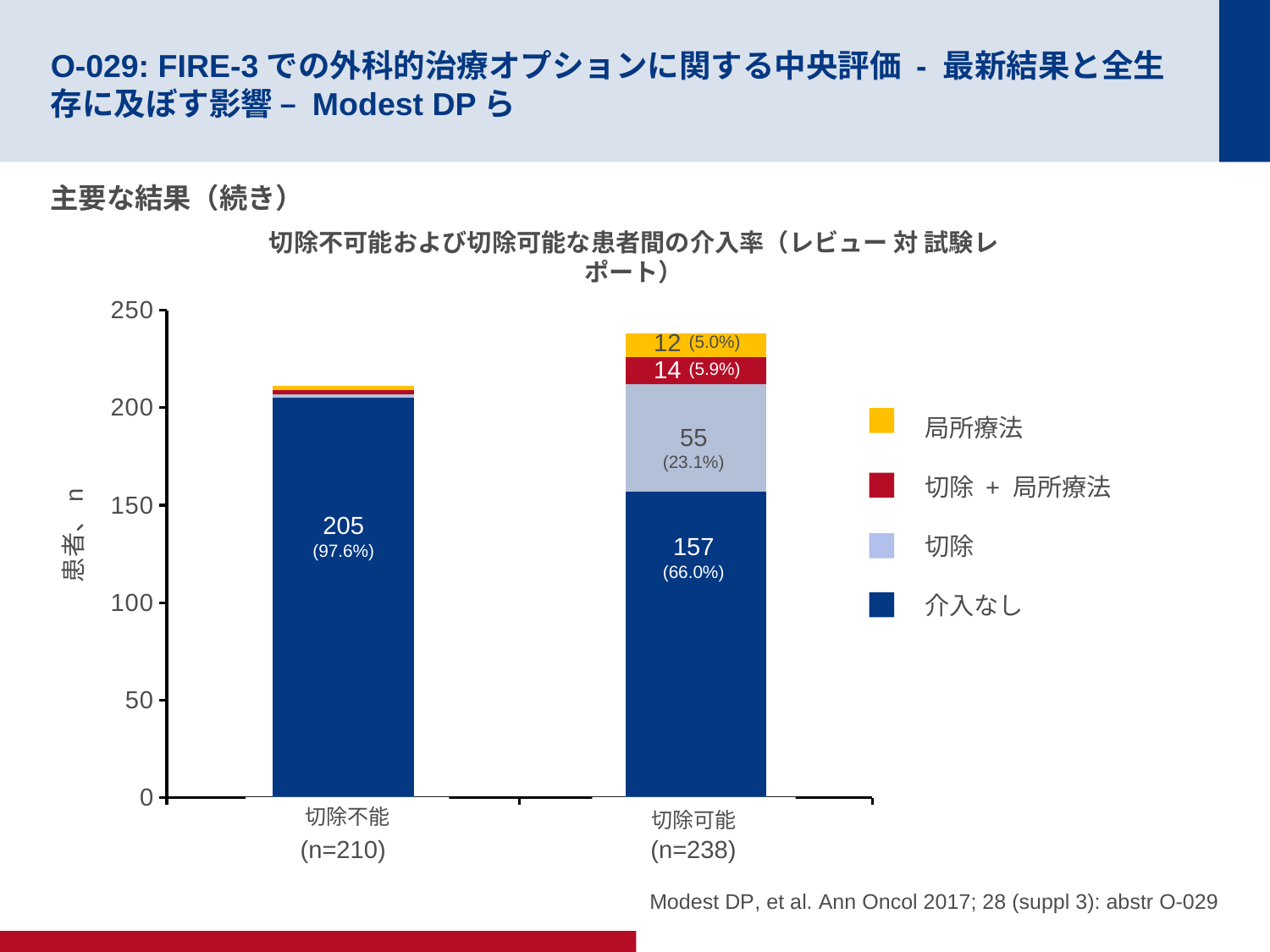
In the 切除可能 (n=238) bar, which segment is larger: 切除 or 局所療法? 切除 What is the total of the 切除可能 (n=238) stacked bar? 238 How many series does the legend list? 4 What is the number of patients with 介入なし in the 切除不能 (n=210) bar? 205 Is the total height of the 切除不能 (n=210) bar greater or less than 200? greater What is the number of patients with 局所療法 in the 切除可能 (n=238) bar? 12 What is the number of patients with 切除 in the 切除可能 (n=238) bar? 55 What is the number of patients with 介入なし in the 切除可能 (n=238) bar? 157 What percentage is shown for 介入なし in the 切除不能 (n=210) bar? 97.6% What percentage is shown for 切除 + 局所療法 in the 切除可能 (n=238) bar? 5.9% What is the difference in the number of 介入なし patients between the 切除不能 bar and the 切除可能 bar? 48 What kind of chart is shown on the slide? Stacked bar chart